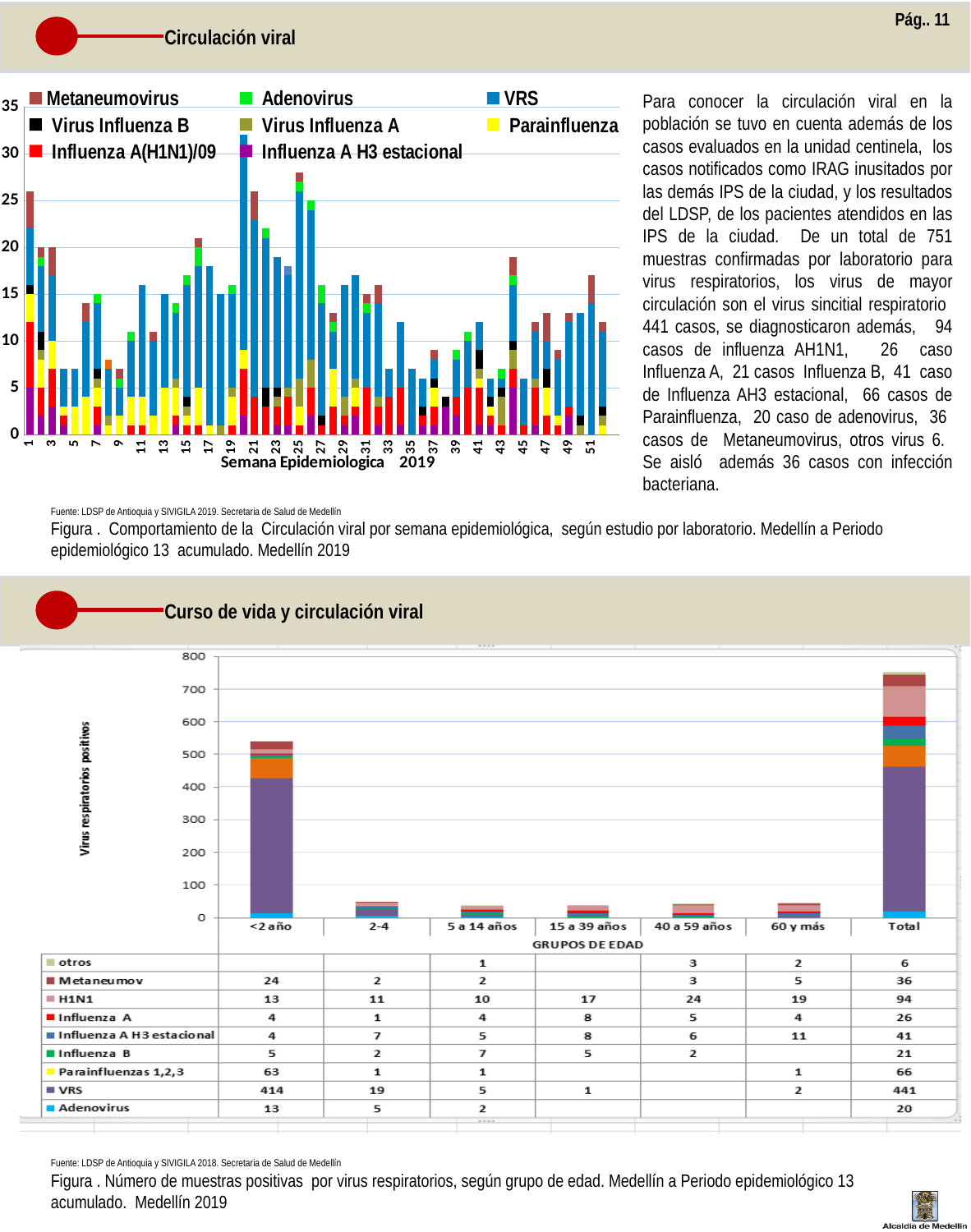
What is the x-axis title of the top chart? Semana Epidemiologica 2019 In the bottom chart, what is the difference between H1N1 cases in the <2 año group and the 2-4 group? 2 In the bottom chart, what is the Total value for Parainfluenzas 1,2,3? 66 In the top chart, is the total for week 35 greater or less than 10? less In the bottom chart, how many H1N1 cases are there for the 40 a 59 años group? 24 In the top chart, is the total for week 20 greater or less than 30? greater In the bottom chart, what is the total of the stacked bar for the <2 año group? 540 What kind of chart is the top chart (Circulación viral by semana epidemiológica)? Stacked bar chart How many series does the legend of the top chart list? 8 In the bottom chart, which is larger for the <2 año group: VRS or Parainfluenzas 1,2,3? VRS In the bottom chart (by grupos de edad), how many VRS cases are there for the <2 año group? 414 In the bottom chart, which age group (excluding Total) has the tallest bar? <2 año